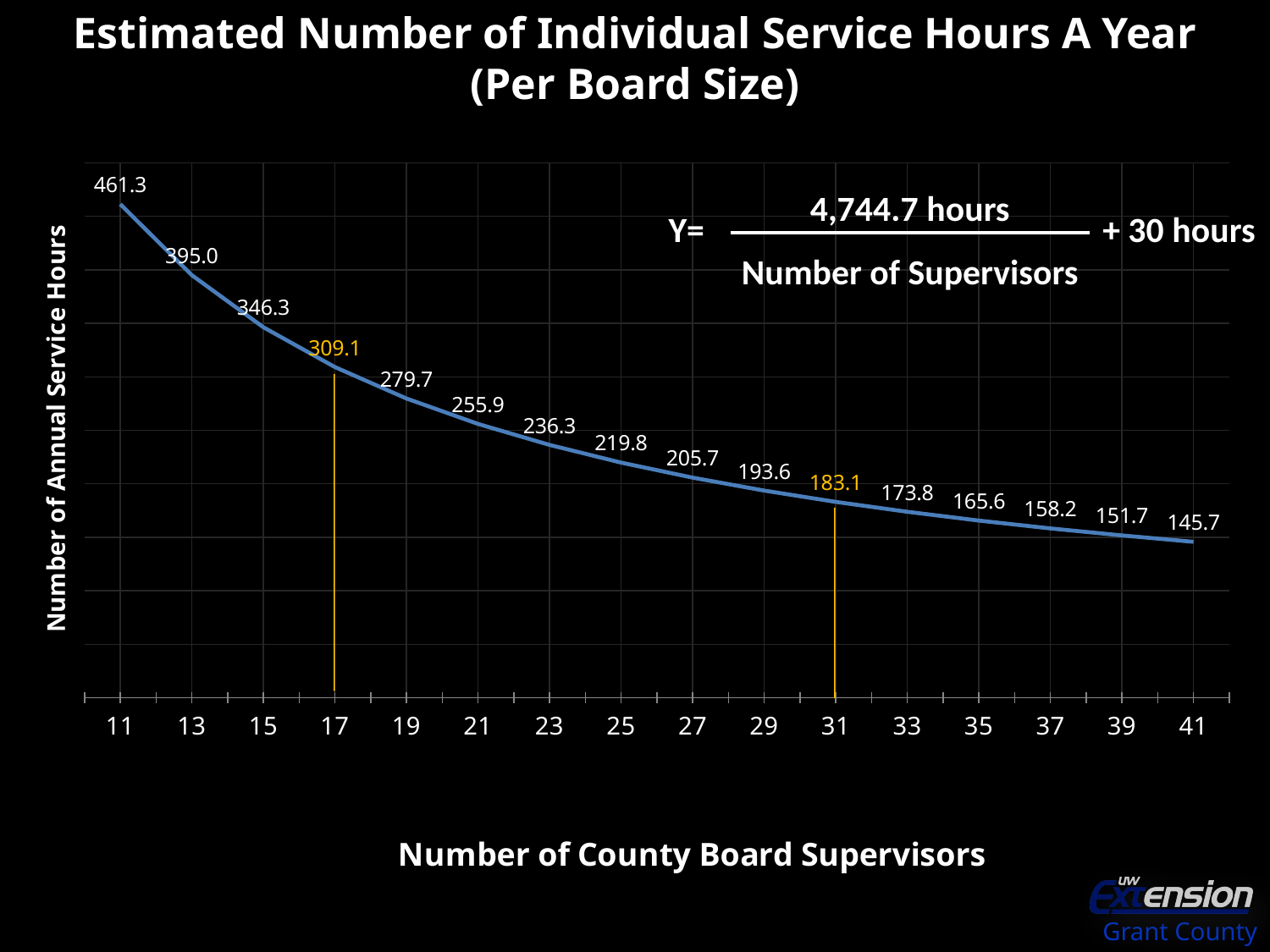
What is the difference in annual service hours between a board of 17 supervisors and a board of 31 supervisors? 126.0 Which has more annual service hours: a board of 23 supervisors or a board of 29 supervisors? 23 Which board size has the lowest number of annual service hours? 41 Do the annual service hours rise or fall as the number of supervisors increases? fall What is the estimated number of annual service hours for a board of 41 supervisors? 145.7 What is the estimated number of annual service hours for a board of 31 supervisors? 183.1 What type of chart is shown on the slide? line chart What is the estimated number of annual service hours for a board of 11 supervisors? 461.3 How many data points are plotted on the line? 16 What is the difference in annual service hours between a board of 11 supervisors and a board of 41 supervisors? 315.6 What is the estimated number of annual service hours for a board of 17 supervisors? 309.1 Which board size has the highest number of annual service hours? 11